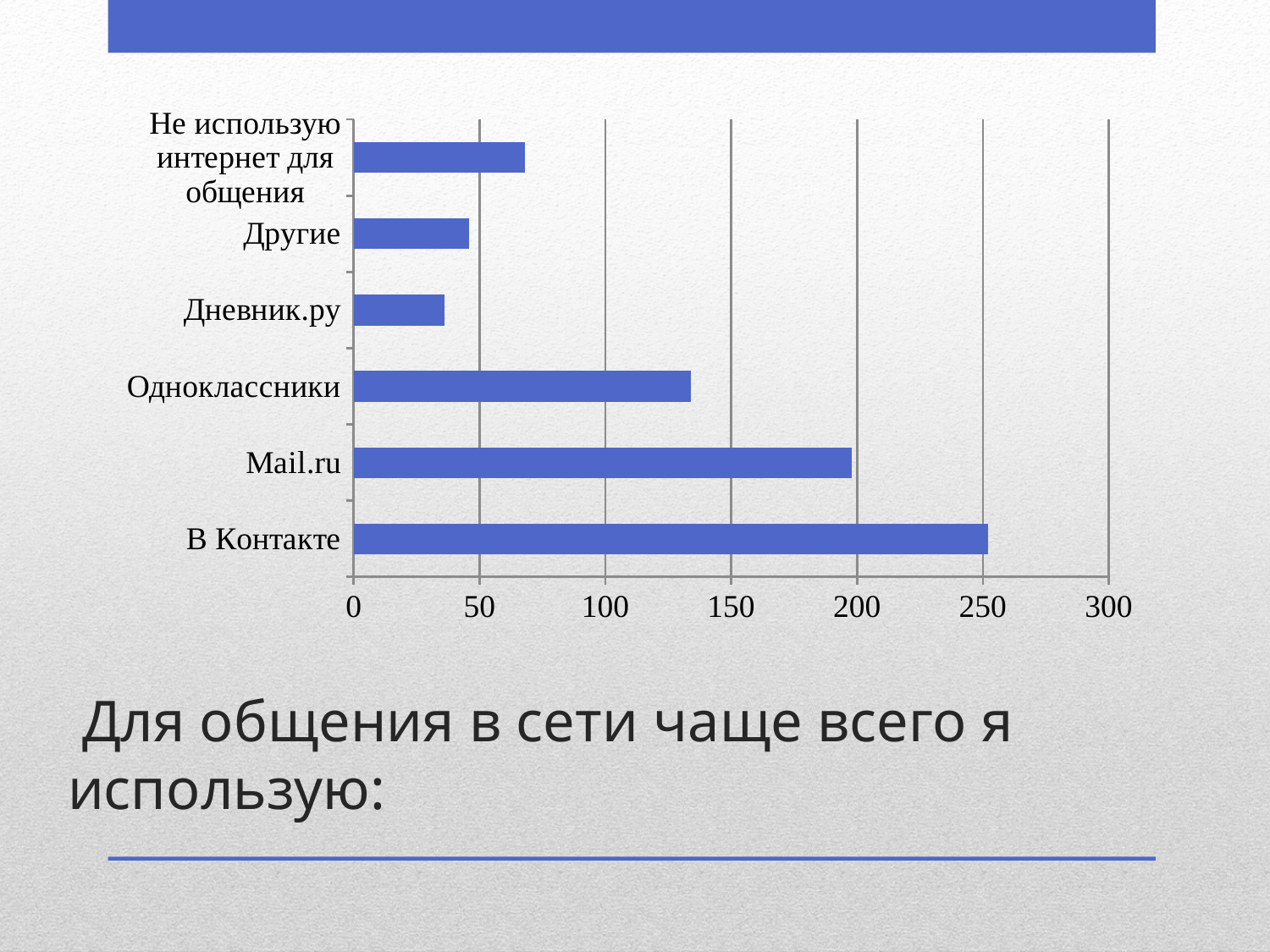
Is the value for Одноклассники greater or less than 150? less Is the value for Дневник.ру greater or less than 50? less Is the value for В Контакте greater or less than 200? greater What kind of chart is shown on the slide? bar chart What is the maximum value shown on the horizontal axis of the chart? 300 Which category has the lowest value in the chart? Дневник.ру How many categories are shown in the chart? 6 Which category has the highest value in the chart? В Контакте Which is larger, the value for Mail.ru or the value for Одноклассники? Mail.ru